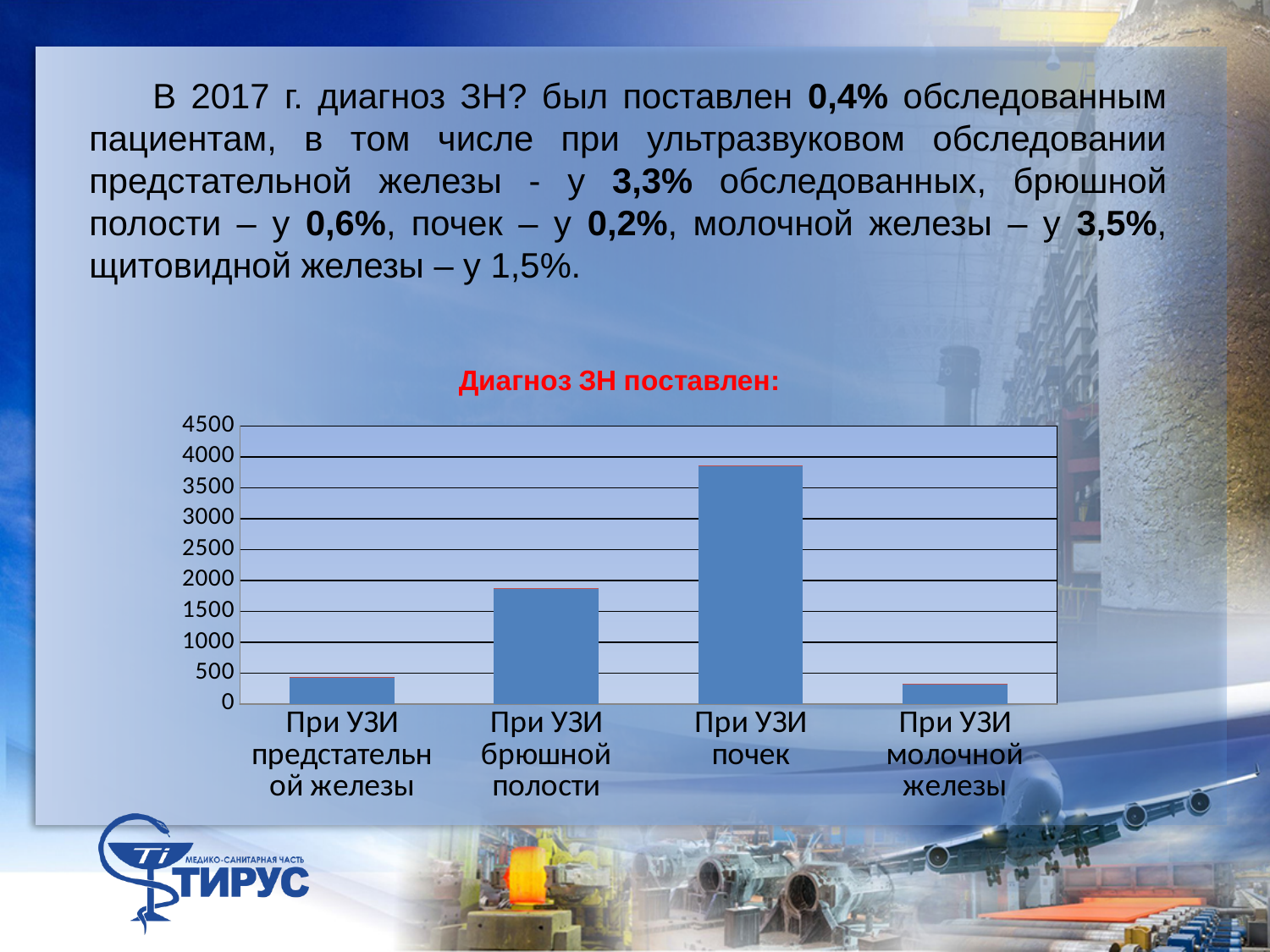
Which is larger: the value for При УЗИ предстательной железы or the value for При УЗИ молочной железы? При УЗИ предстательной железы Is the value for При УЗИ брюшной полости greater or less than 2000? less Is the value for При УЗИ почек greater or less than 3500? greater What kind of chart is shown on the slide? bar chart Is the value for При УЗИ молочной железы greater or less than 500? less How many categories are shown on the chart? 4 Which is larger: the value for При УЗИ почек or the value for При УЗИ брюшной полости? При УЗИ почек What is the title of the chart? Диагноз ЗН поставлен: Which category has the highest value on the chart? При УЗИ почек Which category has the lowest value on the chart? При УЗИ молочной железы What is the highest value shown on the vertical axis of the chart? 4500